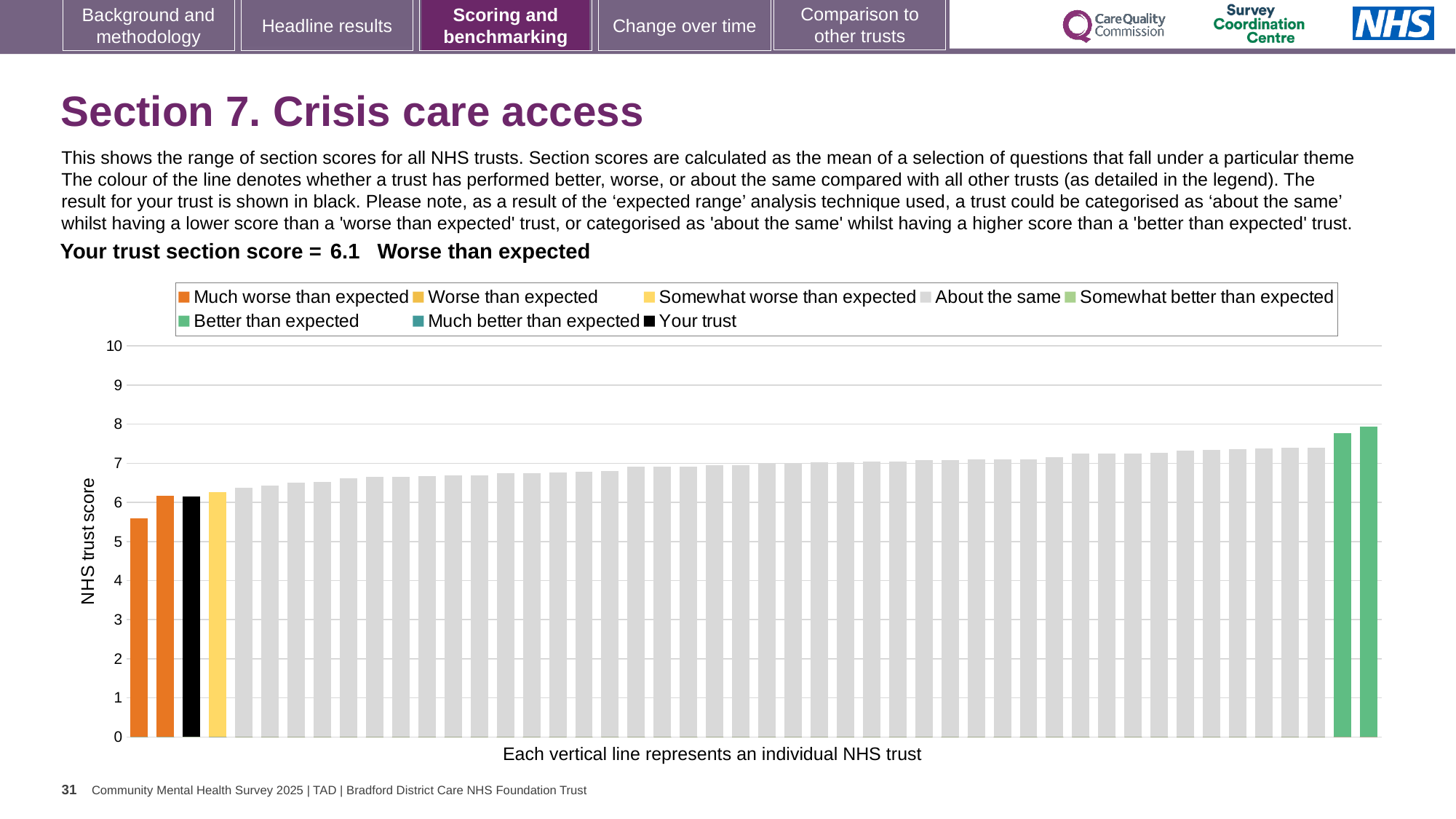
Is the value of the tallest bar (the rightmost green bar) greater or less than 7? greater Is the value of the lowest bar (the leftmost orange bar) greater or less than 6? less How many bars are coloured orange ('Much worse than expected')? 2 How many entries does the chart legend list? 8 How many bars are coloured green ('Better than expected')? 2 What kind of chart is shown on the slide? bar chart Do the bar values rise or fall from left to right along the x axis? rise What is the label on the vertical axis of the chart? NHS trust score What is the section score for your trust shown on the slide? 6.1 Is the value of the black 'Your trust' bar greater or less than 5? greater Which performance category is your trust placed in according to the slide? Worse than expected